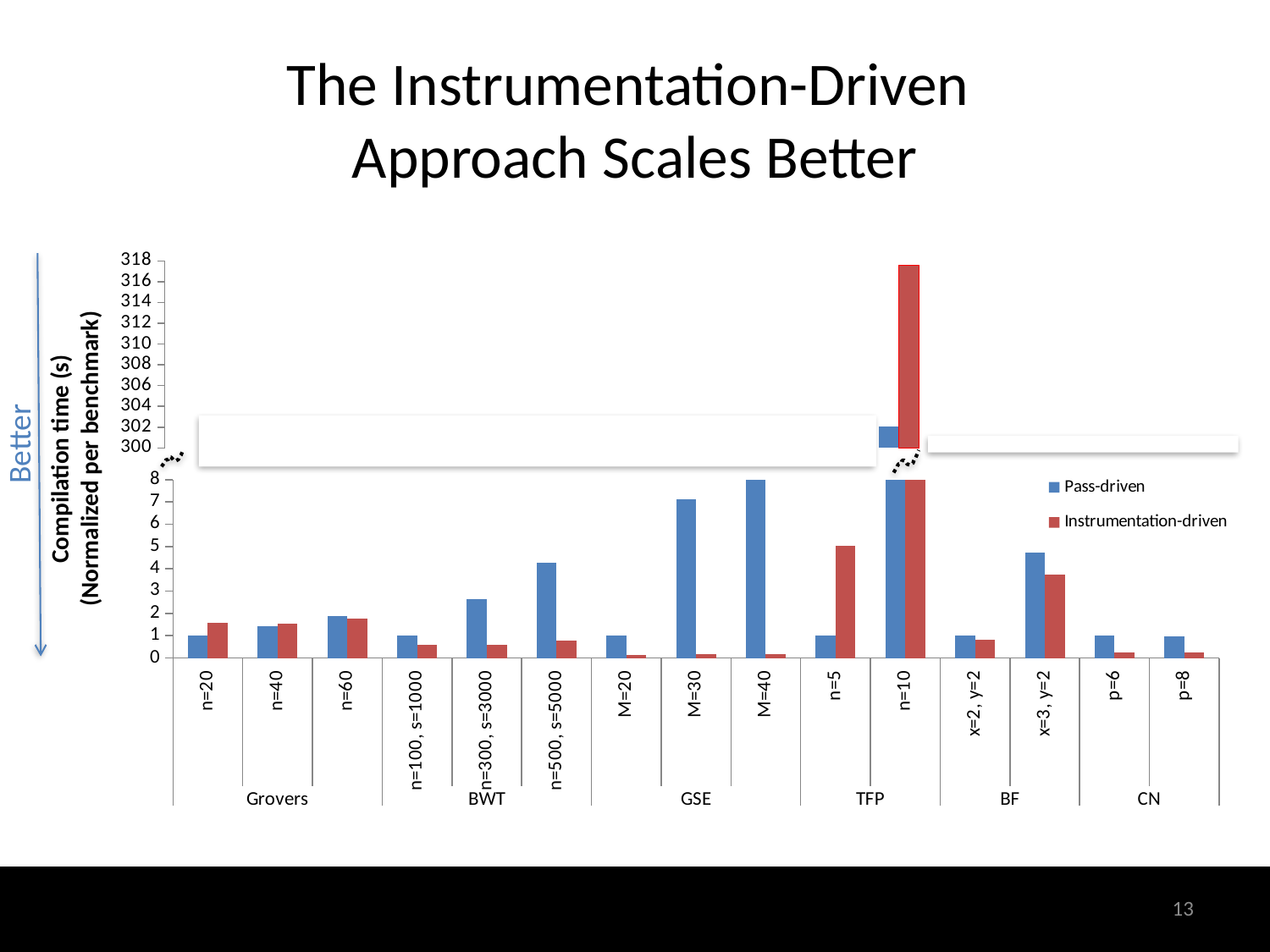
Is the Pass-driven value for x=3, y=2 (BF) greater or less than 4? greater Which configuration has the highest Instrumentation-driven value? n=10 (TFP) Do the Pass-driven values rise or fall across the GSE configurations from M=20 to M=40? rise Is the Instrumentation-driven value for n=10 (TFP) greater or less than 300? greater How many series does the legend list? 2 How many benchmark groups (Grovers, BWT, etc.) are labelled along the x axis? 6 What are the two series named in the legend? Pass-driven and Instrumentation-driven How many benchmark configurations (x-axis categories) are plotted? 15 For M=40 (GSE), which series has the larger value, Pass-driven or Instrumentation-driven? Pass-driven Is the Pass-driven value for M=30 (GSE) greater or less than 5? greater For n=5 (TFP), which series has the larger value, Pass-driven or Instrumentation-driven? Instrumentation-driven What kind of chart is shown on the slide? bar chart